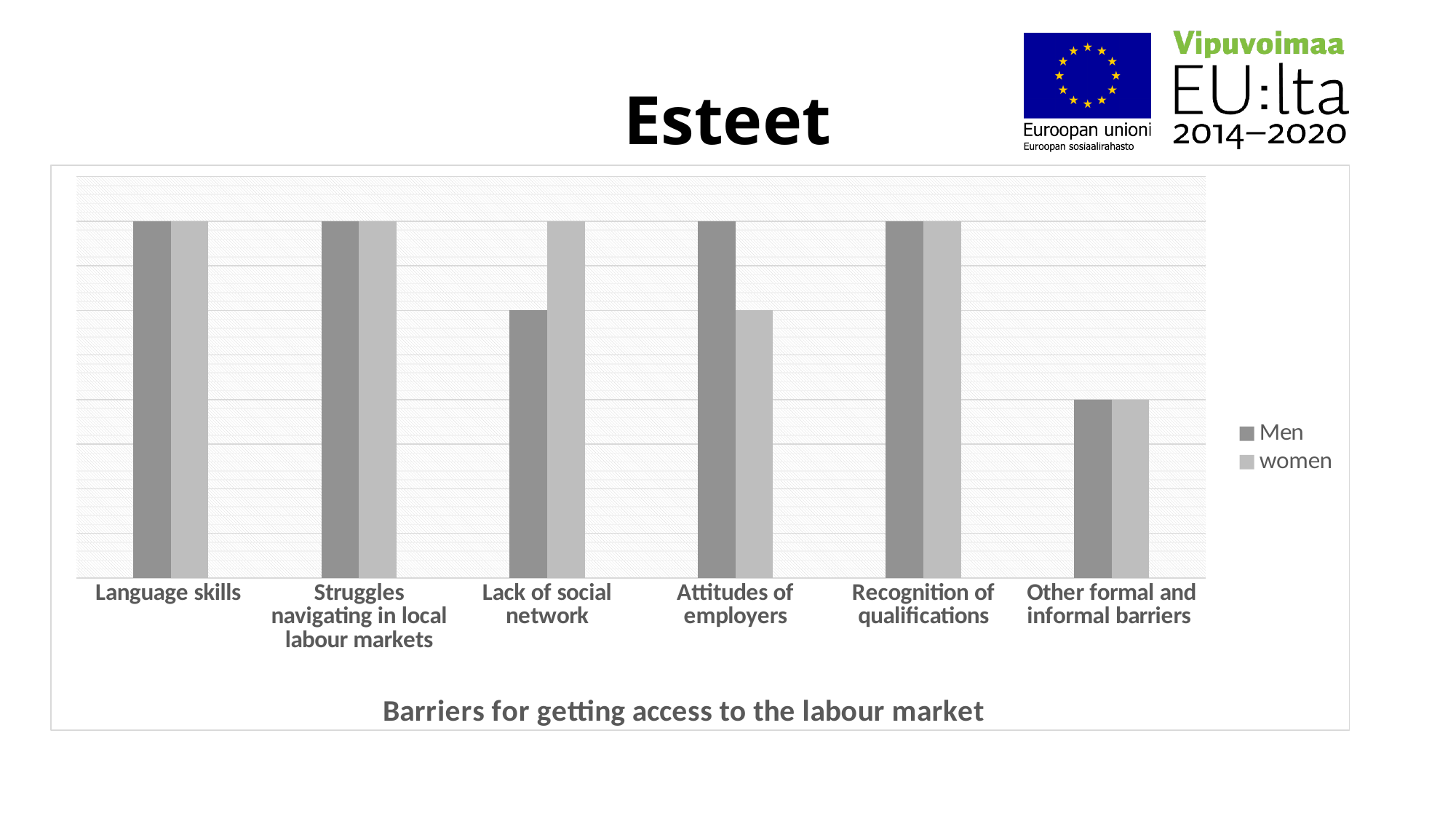
Is the Men bar for 'Language skills' taller or shorter than the Men bar for 'Other formal and informal barriers'? taller Which category has the lowest bar for the Men series? Other formal and informal barriers What kind of chart is shown on the slide? Bar chart For 'Attitudes of employers', which series has the taller bar, Men or women? Men For 'Lack of social network', which series has the taller bar, Men or women? women Which category has the lowest bar for the women series? Other formal and informal barriers How many series does the chart's legend list? 2 What are the two series named in the chart's legend? Men and women What is the title shown below the chart? Barriers for getting access to the labour market How many categories are shown on the x axis of the chart? 6